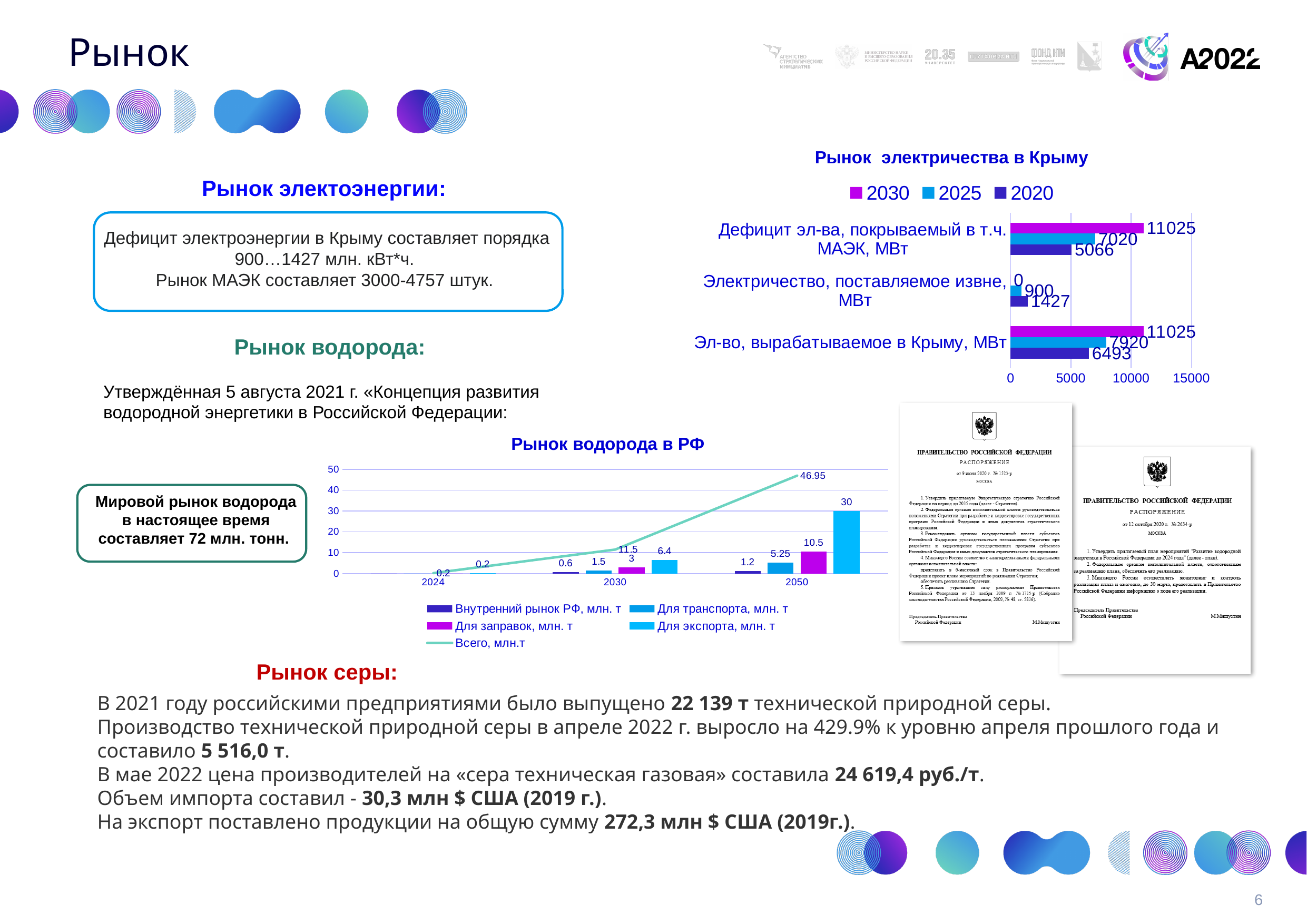
In the chart 'Рынок электричества в Крыму', what is the 2020 value for 'Электричество, поставляемое извне, МВт'? 1427 What kind of chart is 'Рынок электричества в Крыму'? Bar chart In the chart 'Рынок водорода в РФ', does the 'Всего, млн.т' line rise or fall from 2024 to 2050? Rises In the chart 'Рынок электричества в Крыму', what is the 2030 value for 'Эл-во, вырабатываемое в Крыму, МВт'? 11025 In the chart 'Рынок электричества в Крыму', what is the 2025 value for 'Дефицит эл-ва, покрываемый в т.ч. МАЭК, МВт'? 7020 In the chart 'Рынок водорода в РФ', how many series does the legend list? 5 In the chart 'Рынок водорода в РФ', what is the value of 'Всего, млн.т' in 2030? 11.5 In the chart 'Рынок электричества в Крыму', which year has the lowest value for 'Электричество, поставляемое извне, МВт'? 2030 In the chart 'Рынок электричества в Крыму', what is the difference between the 2025 and 2020 values for 'Эл-во, вырабатываемое в Крыму, МВт'? 1427 In the chart 'Рынок водорода в РФ', what is the value of 'Для экспорта, млн. т' in 2050? 30 In the chart 'Рынок водорода в РФ', which is larger in 2050: 'Для заправок, млн. т' or 'Для транспорта, млн. т'? Для заправок, млн. т In the chart 'Рынок электричества в Крыму', how many series does the legend list? 3